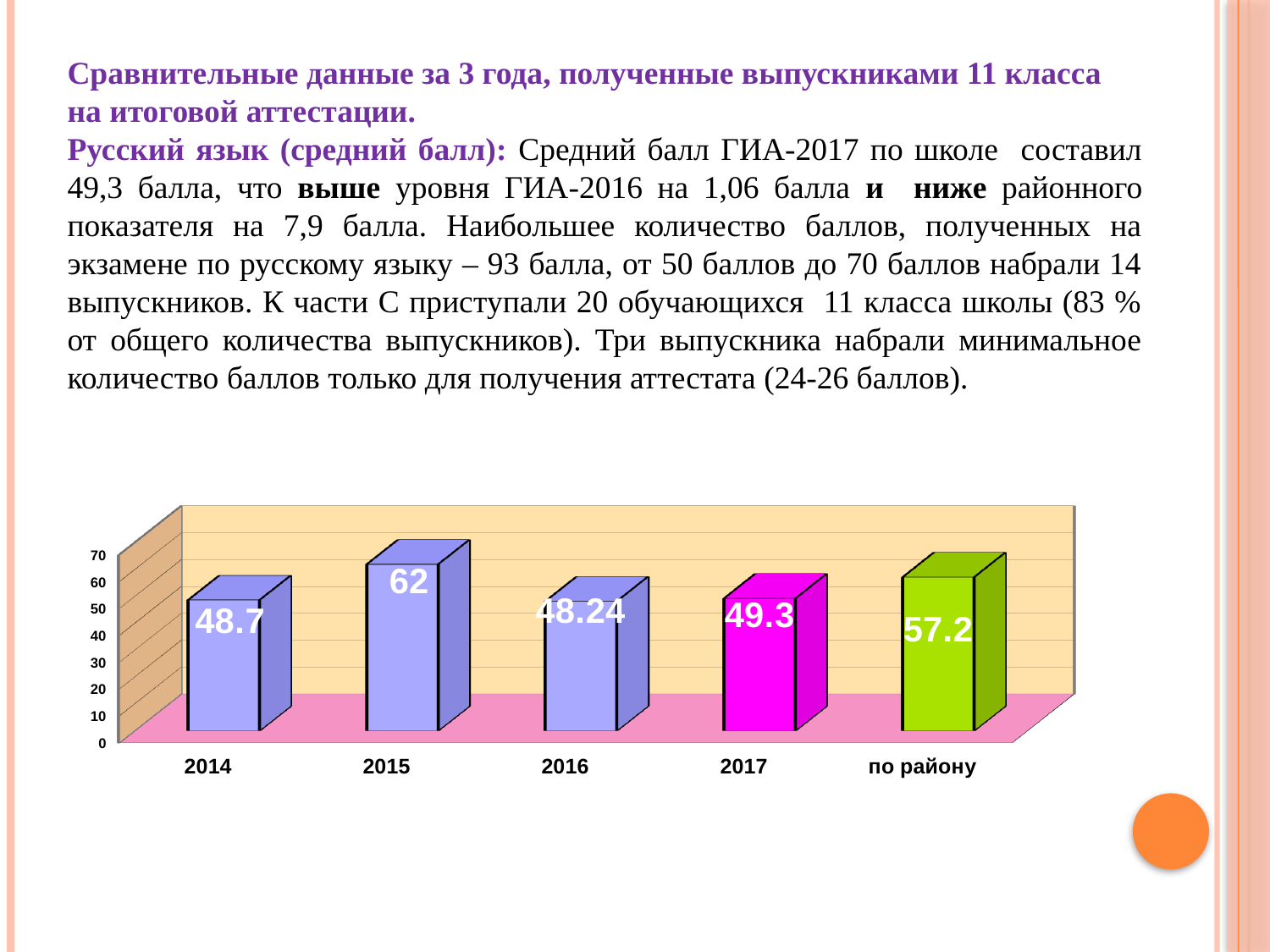
Which is larger, the value for 2015 or the value for "по району"? 2015 Which category has the highest value? 2015 What is the value shown for 2015? 62 What kind of chart is shown on the slide? bar chart What is the difference between the value for "по району" and the value for 2017? 7.9 What is the value shown for 2014? 48.7 What is the value shown for 2017? 49.3 Which category has the lowest value? 2016 What is the value shown for "по району"? 57.2 What is the difference between the values for 2015 and 2014? 13.3 What is the value shown for 2016? 48.24 How many categories are shown on the x axis? 5